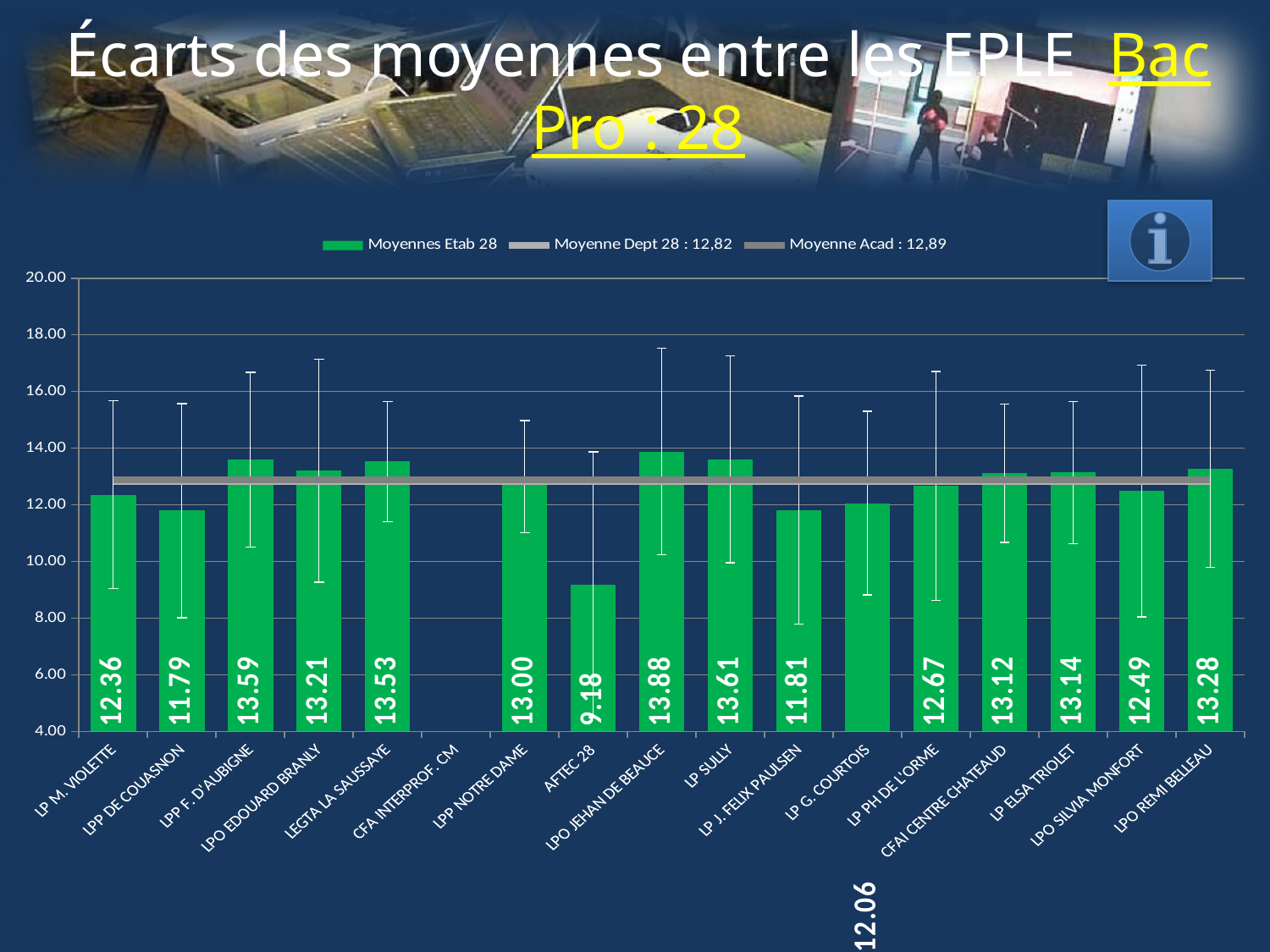
Which is larger, the value for LP M. VIOLETTE or the value for LPP DE COUASNON? LP M. VIOLETTE Is the value for AFTEC 28 greater or less than 10.00? less What is the value for LPO JEHAN DE BEAUCE? 13.88 How many series does the legend list? 3 Which establishment has the highest value? LPO JEHAN DE BEAUCE What is the value for LPP DE COUASNON? 11.79 What is the difference between the values for LPO JEHAN DE BEAUCE and AFTEC 28? 4.70 How many establishments are listed on the x axis? 17 What is the value for LPO SILVIA MONFORT? 12.49 Which establishment has the lowest value? AFTEC 28 What kind of chart is shown on the slide? bar chart